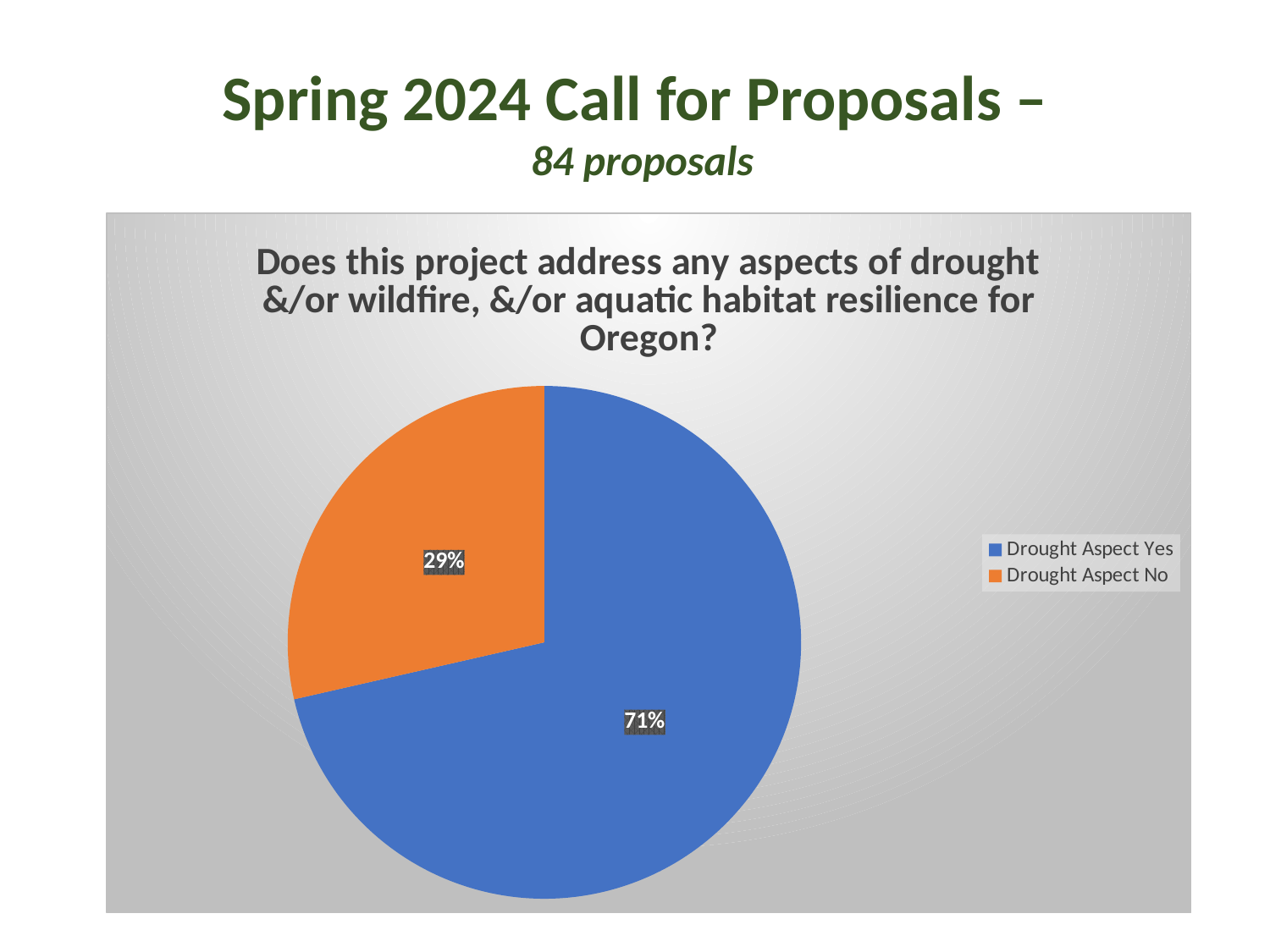
What colour is the 'Drought Aspect No' slice? orange What percentage of proposals are labelled 'Drought Aspect No'? 29% How many slices does the pie chart have? 2 What percentage of proposals are labelled 'Drought Aspect Yes'? 71% Which is larger: the 'Drought Aspect Yes' slice or the 'Drought Aspect No' slice? Drought Aspect Yes What type of chart is shown on the slide? pie chart How many entries does the legend list? 2 What share of the pie does the 'Drought Aspect No' slice represent? 29% Which slice of the pie is the smallest? Drought Aspect No What is the difference in percentage points between the 'Drought Aspect Yes' and 'Drought Aspect No' slices? 42 What is the title of the chart? Does this project address any aspects of drought &/or wildfire, &/or aquatic habitat resilience for Oregon? Which slice of the pie is the largest? Drought Aspect Yes